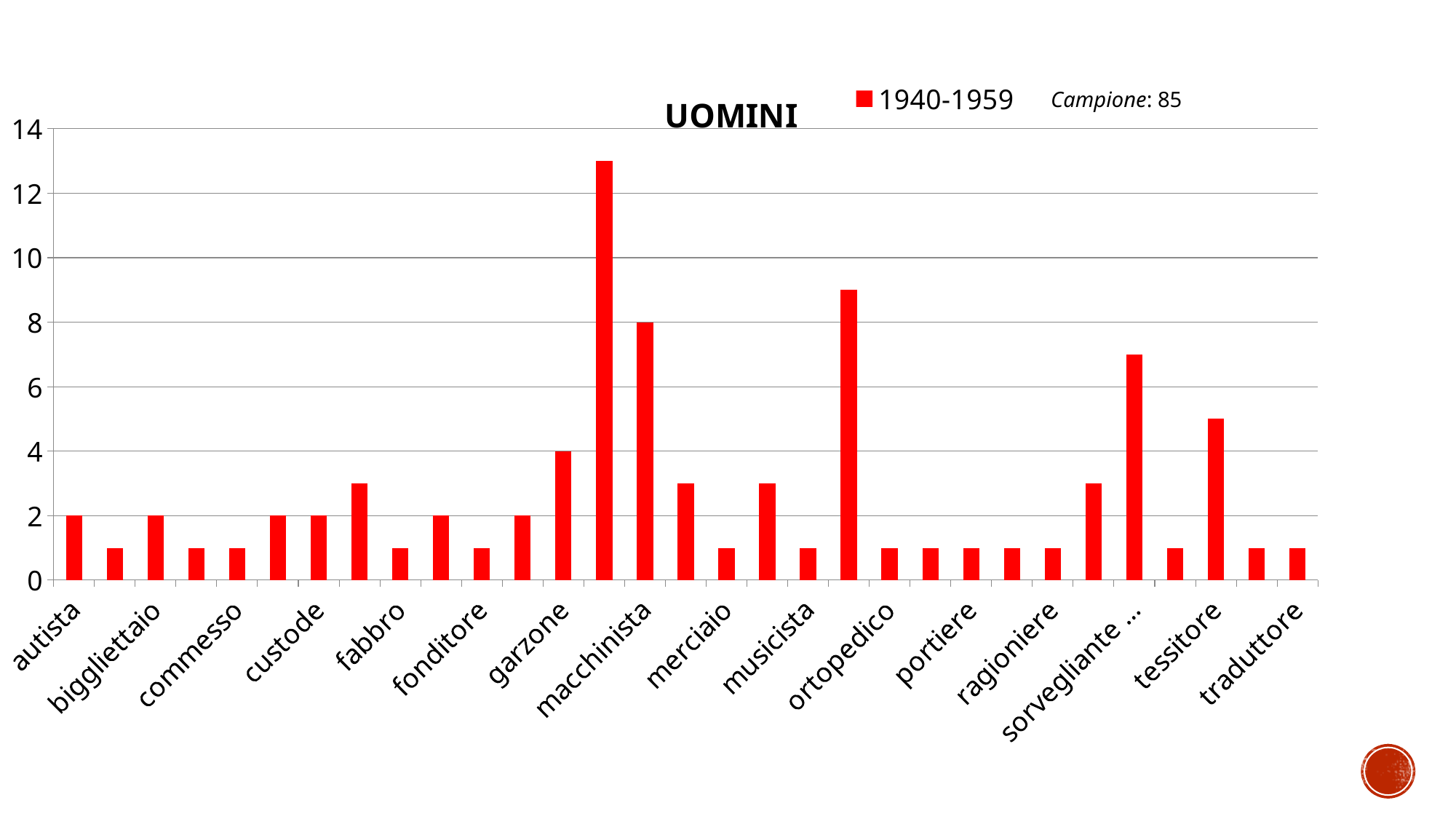
What type of chart is shown on the slide? bar chart What is the value for garzone? 4 What is the value for autista? 2 What is the title of the chart? UOMINI Is the value for commesso greater or less than 2? less Which is larger, the value for macchinista or the value for garzone? macchinista What is the difference between the values for macchinista and garzone? 4 What is the value for custode? 2 What is the value for macchinista? 8 Is the value for sorvegliante greater or less than 6? greater What series name is shown in the legend? 1940-1959 How many series does the legend list? 1